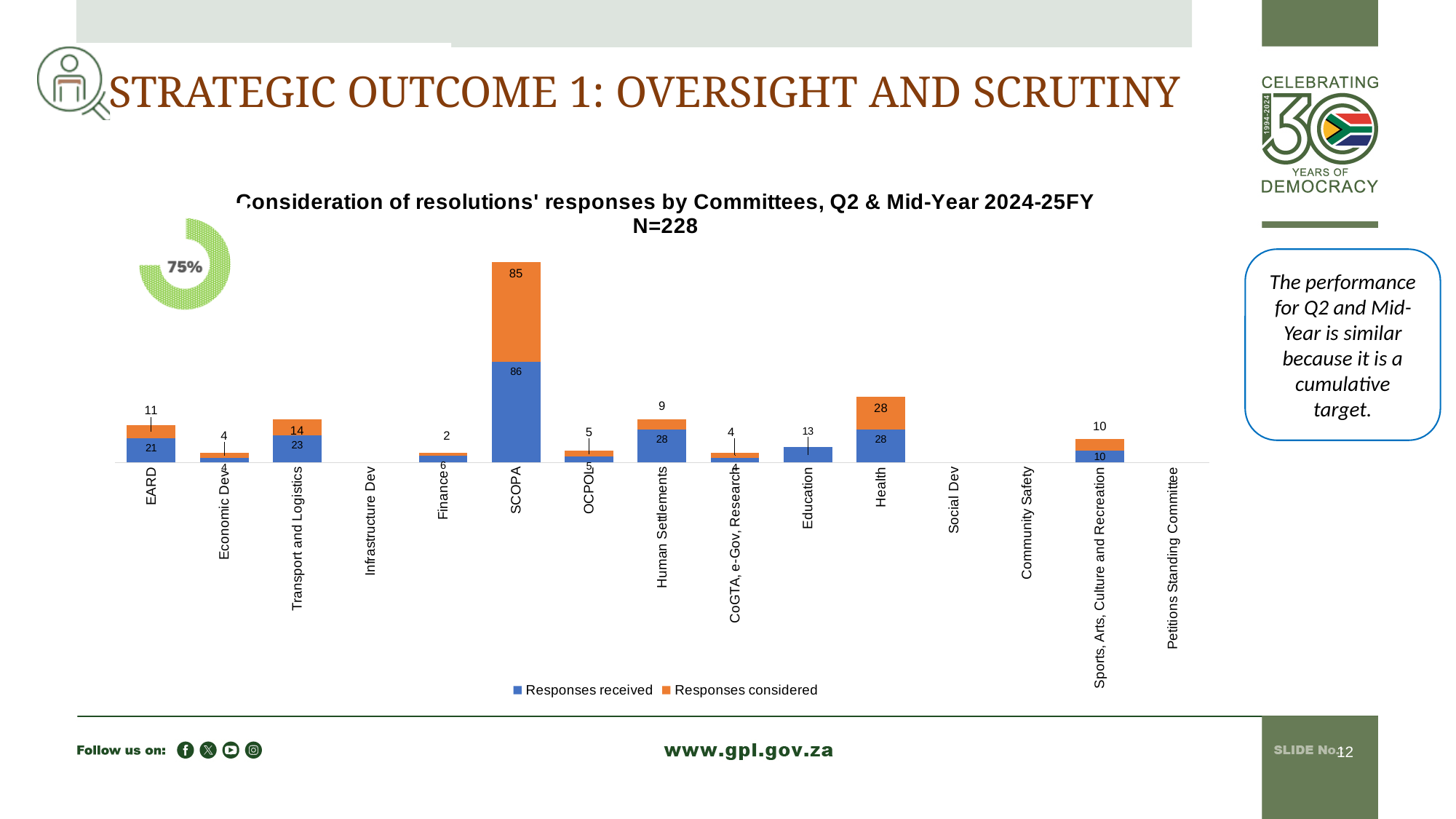
What is the value of Responses considered for Human Settlements? 9 What is the value of Responses considered for Health? 28 What is the value of Responses considered for SCOPA? 85 How many series does the legend list? 2 Which has more Responses received, EARD or Transport and Logistics? Transport and Logistics What is the value of Responses received for Education? 13 How many committees are listed on the x axis of the chart? 15 Which committee has the highest number of Responses received? SCOPA What is the value of Responses received for SCOPA? 86 What is the difference between Responses received and Responses considered for Human Settlements? 19 What kind of chart is shown on the slide? Stacked bar chart What is the total of the stacked bar for SCOPA? 171